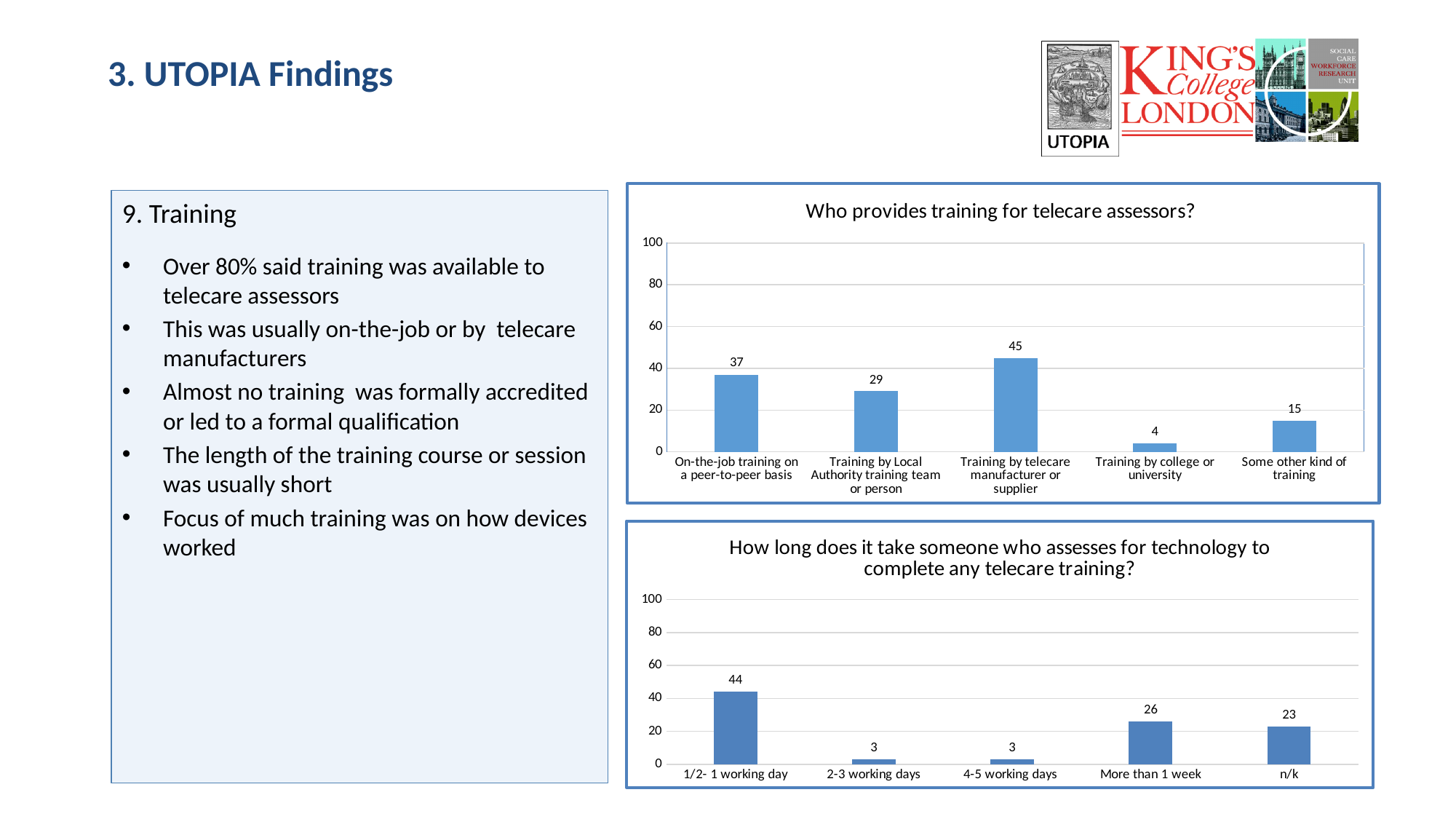
In the chart 'Who provides training for telecare assessors?', which category has the lowest value? Training by college or university What is the title of the top chart on the slide? Who provides training for telecare assessors? In the chart 'How long does it take someone who assesses for technology to complete any telecare training?', what is the difference between '1/2- 1 working day' and 'n/k'? 21 In the chart 'Who provides training for telecare assessors?', what is the difference between 'On-the-job training on a peer-to-peer basis' and 'Training by Local Authority training team or person'? 8 In the chart 'Who provides training for telecare assessors?', how many categories are shown? 5 In the chart 'How long does it take someone who assesses for technology to complete any telecare training?', what is the value for 'More than 1 week'? 26 In the chart 'How long does it take someone who assesses for technology to complete any telecare training?', which category has the highest value? 1/2- 1 working day In the chart 'How long does it take someone who assesses for technology to complete any telecare training?', which is larger: 'More than 1 week' or 'n/k'? More than 1 week In the chart 'Who provides training for telecare assessors?', what is the value for 'Training by telecare manufacturer or supplier'? 45 In the chart 'Who provides training for telecare assessors?', which category has the highest value? Training by telecare manufacturer or supplier In the chart 'Who provides training for telecare assessors?', is the value for 'Some other kind of training' greater or less than 20? less What kind of chart is the bottom chart on the slide? Bar chart